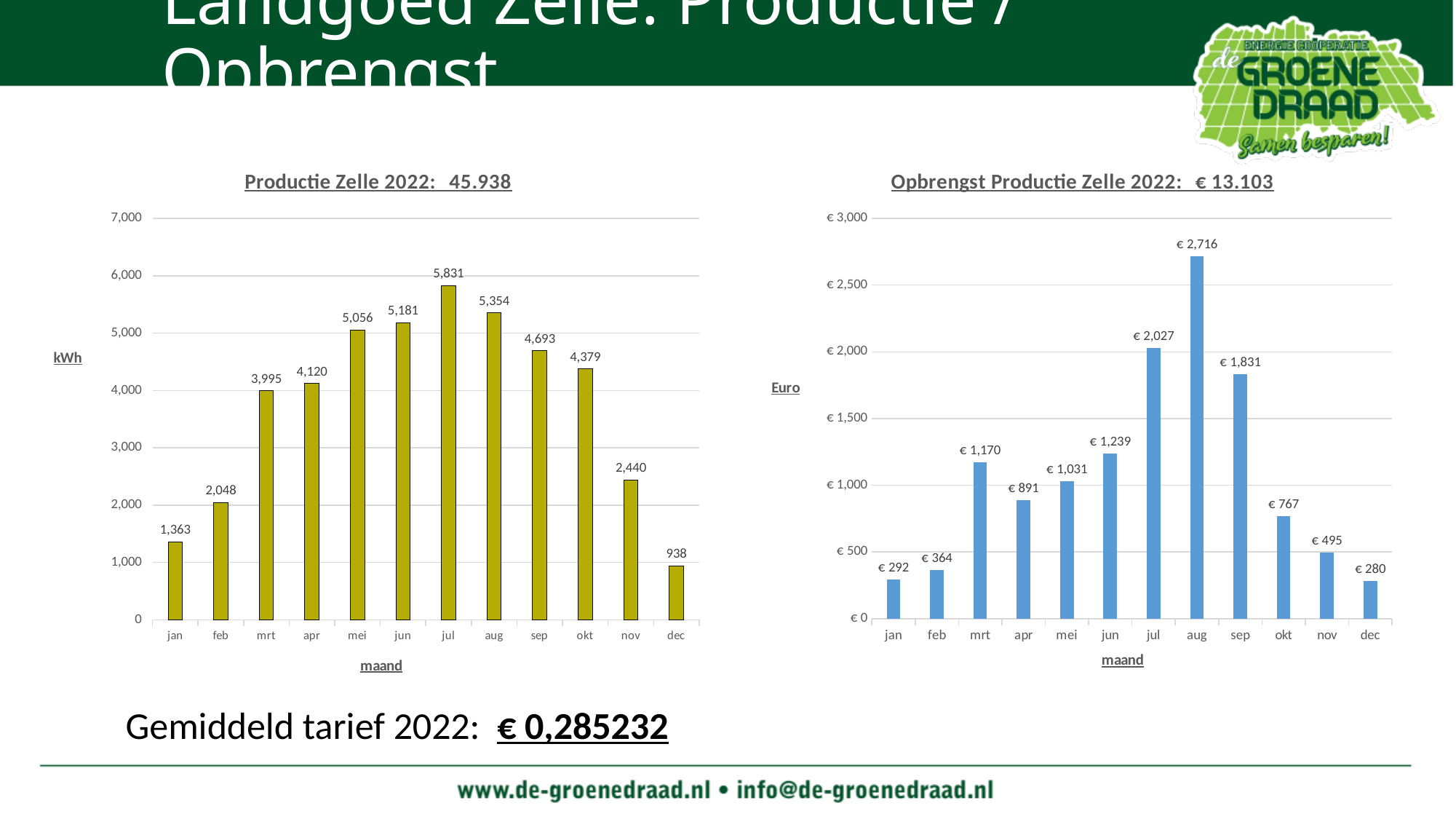
In the 'Opbrengst Productie Zelle 2022' chart, what is the difference between the values for jul and sep? € 196 In the 'Opbrengst Productie Zelle 2022' chart, what is the value for mrt? € 1,170 How many months are shown on the x axis of the 'Opbrengst Productie Zelle 2022' chart? 12 In the 'Productie Zelle 2022' chart, what is the value for dec? 938 In the 'Opbrengst Productie Zelle 2022' chart, which is larger, the value for apr or the value for mei? mei In the 'Productie Zelle 2022' chart, which month has the lowest value? dec In the 'Opbrengst Productie Zelle 2022' chart, which month has the highest value? aug In the 'Productie Zelle 2022' chart, what is the value for jul? 5,831 In the 'Productie Zelle 2022' chart, is the value for nov greater or less than 3,000? less In the 'Opbrengst Productie Zelle 2022' chart, what is the value for aug? € 2,716 What kind of chart is the 'Productie Zelle 2022' chart? bar chart In the 'Productie Zelle 2022' chart, what is the difference between the values for aug and sep? 661